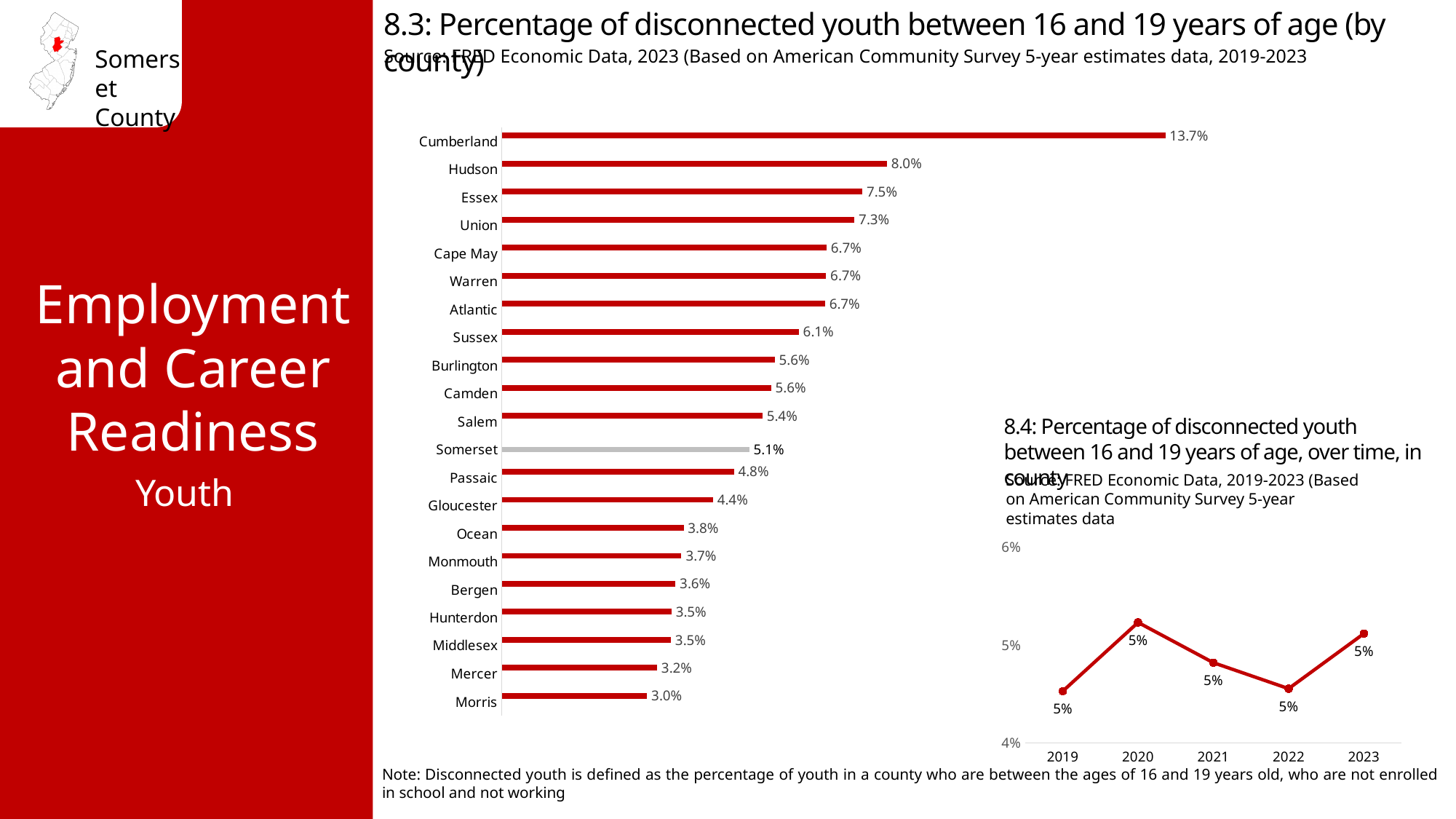
In chart 8.3 (by county), which has a higher value, Essex or Union? Essex What type of chart is chart 8.3 (by county)? Bar chart In chart 8.4 (over time), how many years are plotted? 5 In chart 8.3 (by county), what is the value for Hudson? 8.0% In chart 8.3 (by county), which county has the highest percentage of disconnected youth? Cumberland In chart 8.3 (by county), what is the difference between Cumberland and Hudson? 5.7% In chart 8.4 (over time), is the value for 2020 greater or less than 5%? greater In chart 8.3 (by county), which county has the lowest percentage of disconnected youth? Morris In chart 8.3 (by county), what is the difference between Somerset and Morris? 2.1% In chart 8.3 (by county), how many counties are shown? 21 In chart 8.3 (by county), what is the percentage of disconnected youth for Somerset? 5.1%